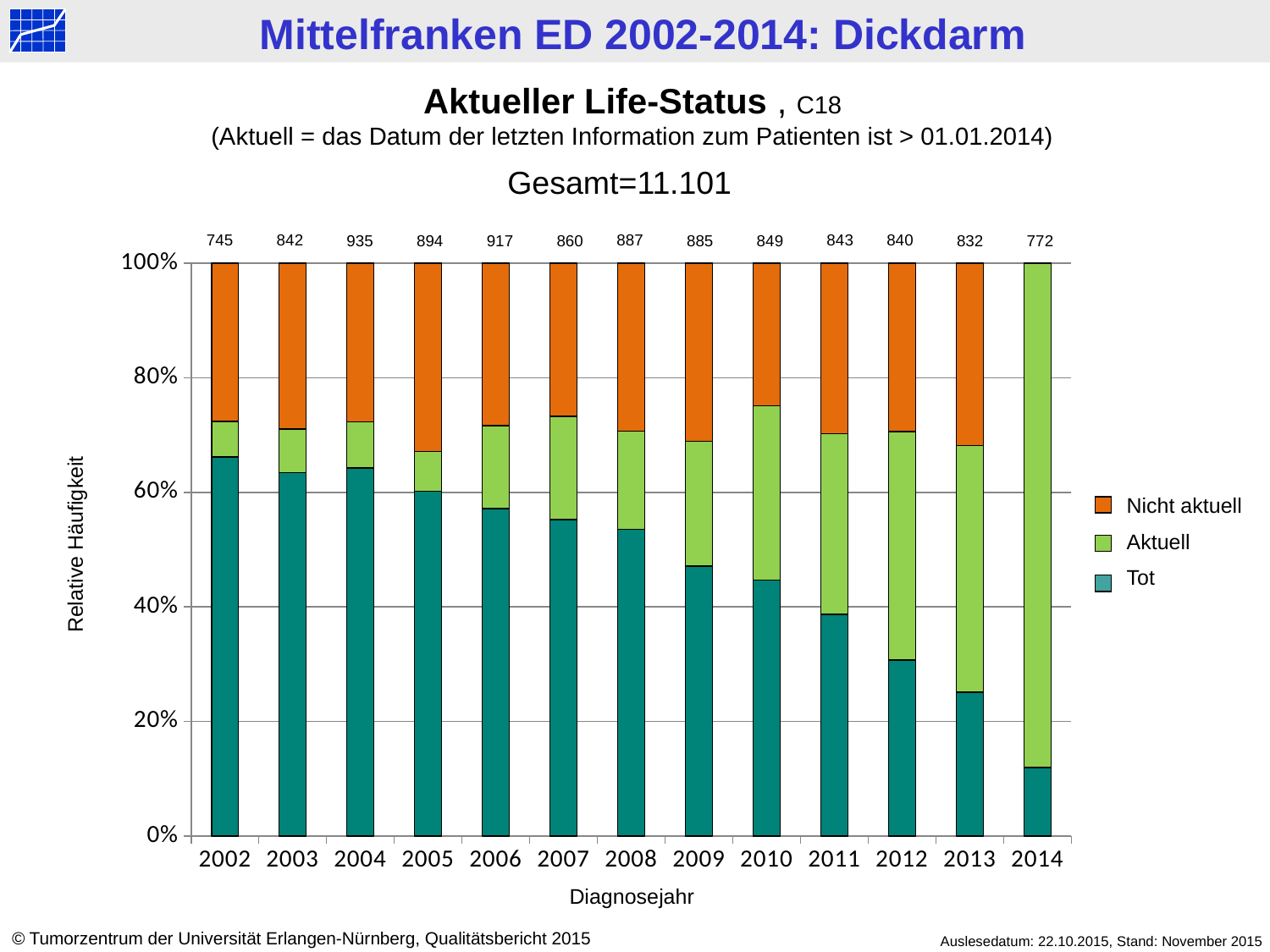
How many series does the legend list? 3 What is the number printed above the bar for 2004? 935 Does the 'Tot' share rise or fall from 2002 to 2014? Fall How many diagnosis years are shown on the x axis? 13 What is the difference between the numbers printed above the bars for 2004 and 2002? 190 Which diagnosis year has the highest number printed above its bar? 2004 What is the number printed above the bar for 2014? 772 Is the 'Tot' share for 2002 greater or less than 60%? greater Which diagnosis year has the lowest number printed above its bar? 2002 Which has a larger number printed above its bar, 2003 or 2005? 2005 Is the 'Tot' share for 2014 greater or less than 20%? less What kind of chart is shown on the slide? Stacked bar chart